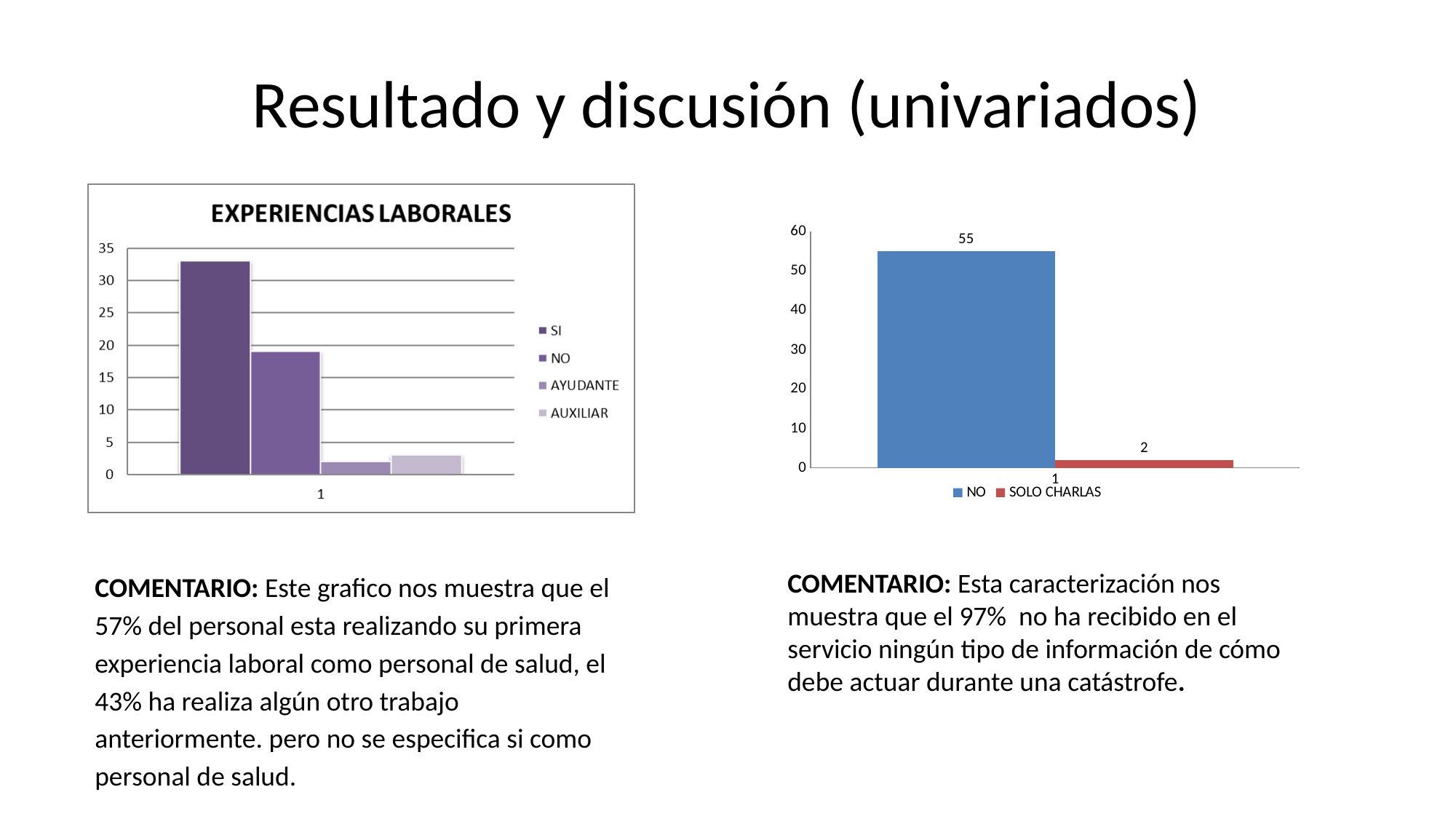
What kind of chart is the EXPERIENCIAS LABORALES chart? bar chart In the EXPERIENCIAS LABORALES chart, which is larger, SI or NO? SI In the EXPERIENCIAS LABORALES chart, is the value for AUXILIAR greater or less than 5? less In the EXPERIENCIAS LABORALES chart, which series has the highest value? SI How many series does the legend of the chart on the right list? 2 In the chart on the right, what is the value for SOLO CHARLAS? 2 In the EXPERIENCIAS LABORALES chart, is the value for SI greater or less than 30? greater How many series does the legend of the EXPERIENCIAS LABORALES chart list? 4 In the chart on the right, what is the value for NO? 55 In the chart on the right, which series has the lowest value? SOLO CHARLAS In the chart on the right, what is the difference between the values for NO and SOLO CHARLAS? 53